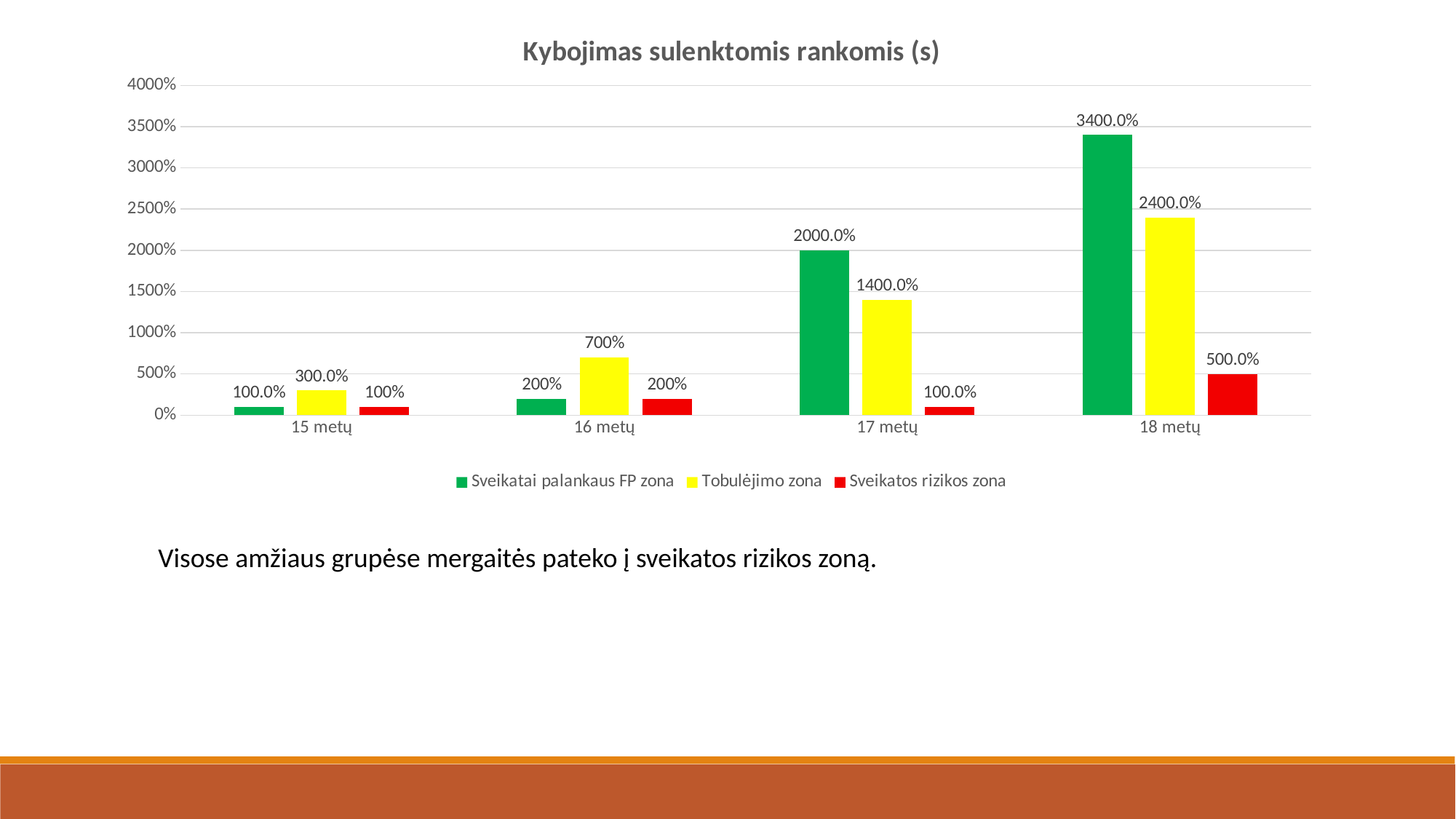
Which age group has the highest value for Tobulėjimo zona? 18 metų What is the value for Sveikatai palankaus FP zona at 18 metų? 3400.0% How many series does the legend list? 3 What is the value for Sveikatos rizikos zona at 18 metų? 500.0% At 15 metų, which is larger: Tobulėjimo zona or Sveikatai palankaus FP zona? Tobulėjimo zona What is the value for Tobulėjimo zona at 16 metų? 700% What is the title of the chart? Kybojimas sulenktomis rankomis (s) What is the difference between the Sveikatai palankaus FP zona and Tobulėjimo zona values at 17 metų? 600.0% How many age-group categories are shown on the x axis? 4 Does the value for Sveikatai palankaus FP zona rise or fall from 15 metų to 18 metų? rise What kind of chart is shown on the slide? bar chart Which age group has the lowest value for Sveikatai palankaus FP zona? 15 metų